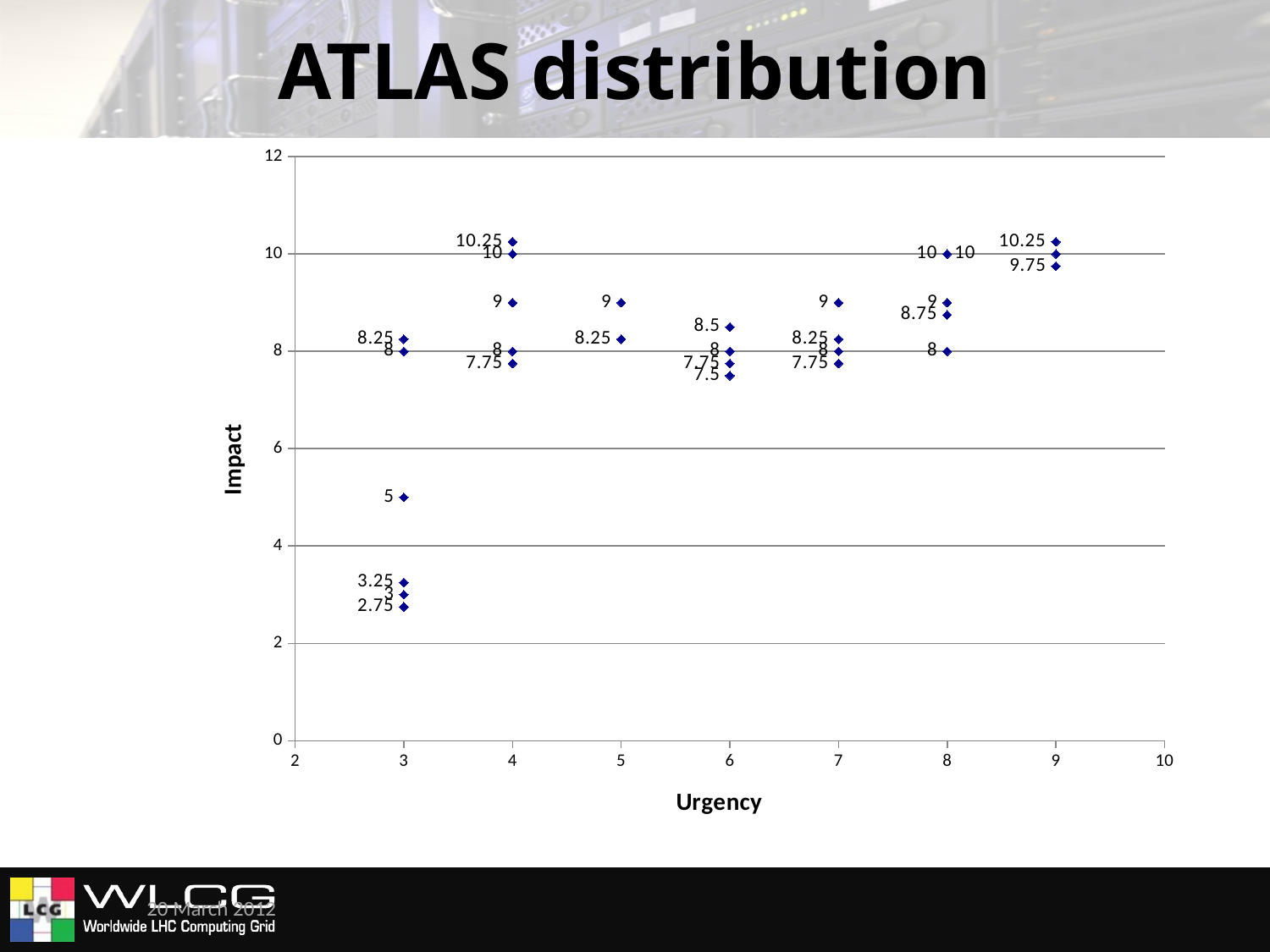
Which has the higher maximum Impact value: Urgency 5 or Urgency 6? Urgency 5 At Urgency 6, what is the lowest labelled Impact value? 7.5 What is the highest Impact value labelled on the chart? 10.25 What is the lowest Impact value labelled on the chart? 2.75 What is the difference between the highest and lowest Impact values at Urgency 3? 5.5 Is the Impact value of the point labelled 5 at Urgency 3 greater or less than 6? less What are the x-axis and y-axis titles of the chart? Urgency (x-axis) and Impact (y-axis) How many data points are plotted at Urgency 5? 2 What kind of chart is shown on the slide? scatter chart What is the title of the chart? ATLAS distribution At Urgency 6, what is the highest labelled Impact value? 8.5 At Urgency 3, what is the lowest labelled Impact value? 2.75